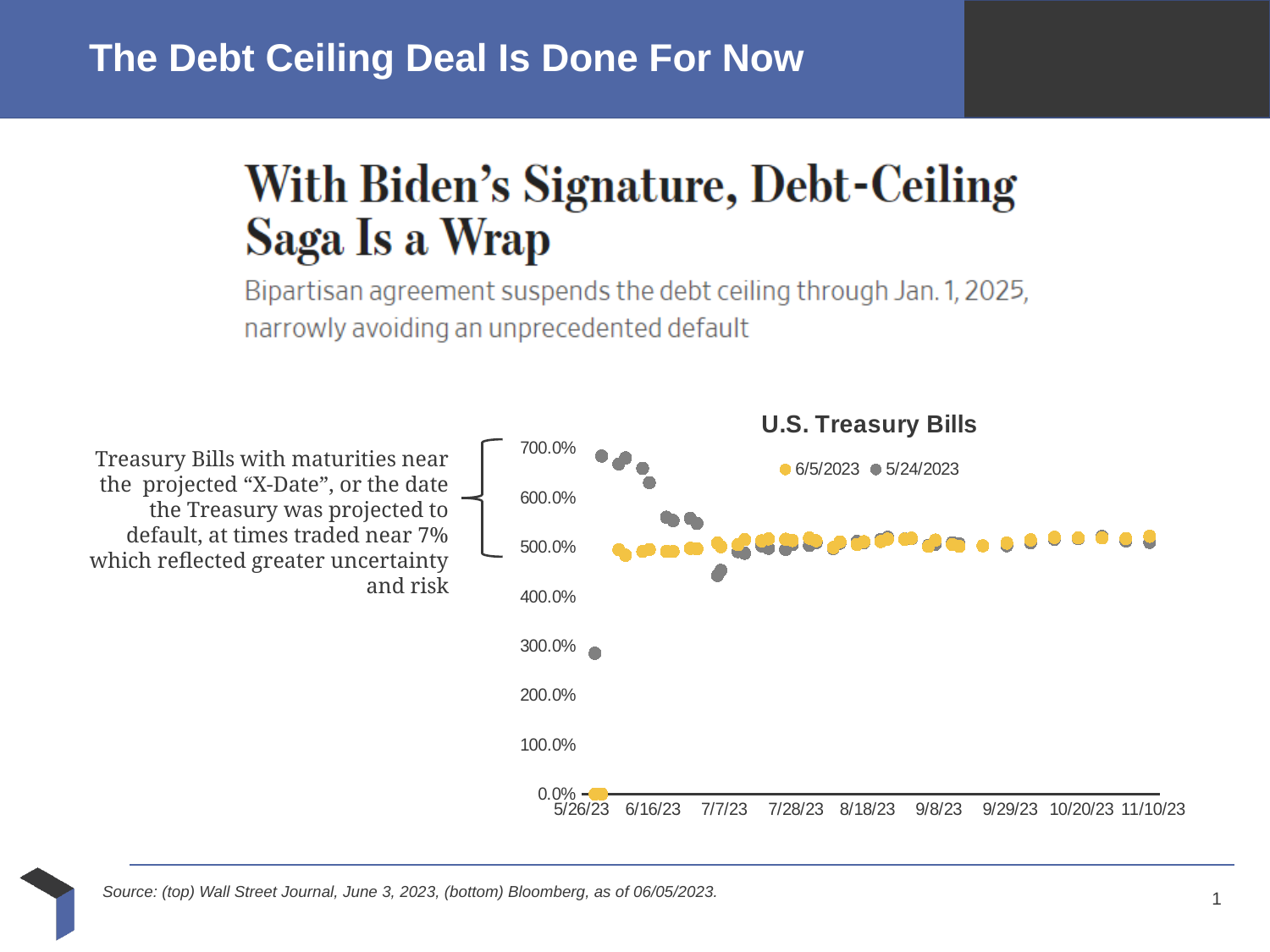
Is the 6/5/2023 value at 11/10/23 in the "U.S. Treasury Bills" chart greater or less than 600.0%? less What is the title of the chart on the slide? U.S. Treasury Bills Is the highest 5/24/2023 value in the "U.S. Treasury Bills" chart greater or less than 600.0%? greater What kind of chart is the "U.S. Treasury Bills" chart? scatter chart Is the 5/24/2023 value at 11/10/23 in the "U.S. Treasury Bills" chart greater or less than 400.0%? greater What are the two series named in the legend of the "U.S. Treasury Bills" chart? 6/5/2023 and 5/24/2023 How many date labels are shown on the x axis of the "U.S. Treasury Bills" chart? 9 Around 6/16/23, which series is higher in the "U.S. Treasury Bills" chart, 6/5/2023 or 5/24/2023? 5/24/2023 Which series reaches the highest plotted value in the "U.S. Treasury Bills" chart? 5/24/2023 How many series does the legend of the "U.S. Treasury Bills" chart list? 2